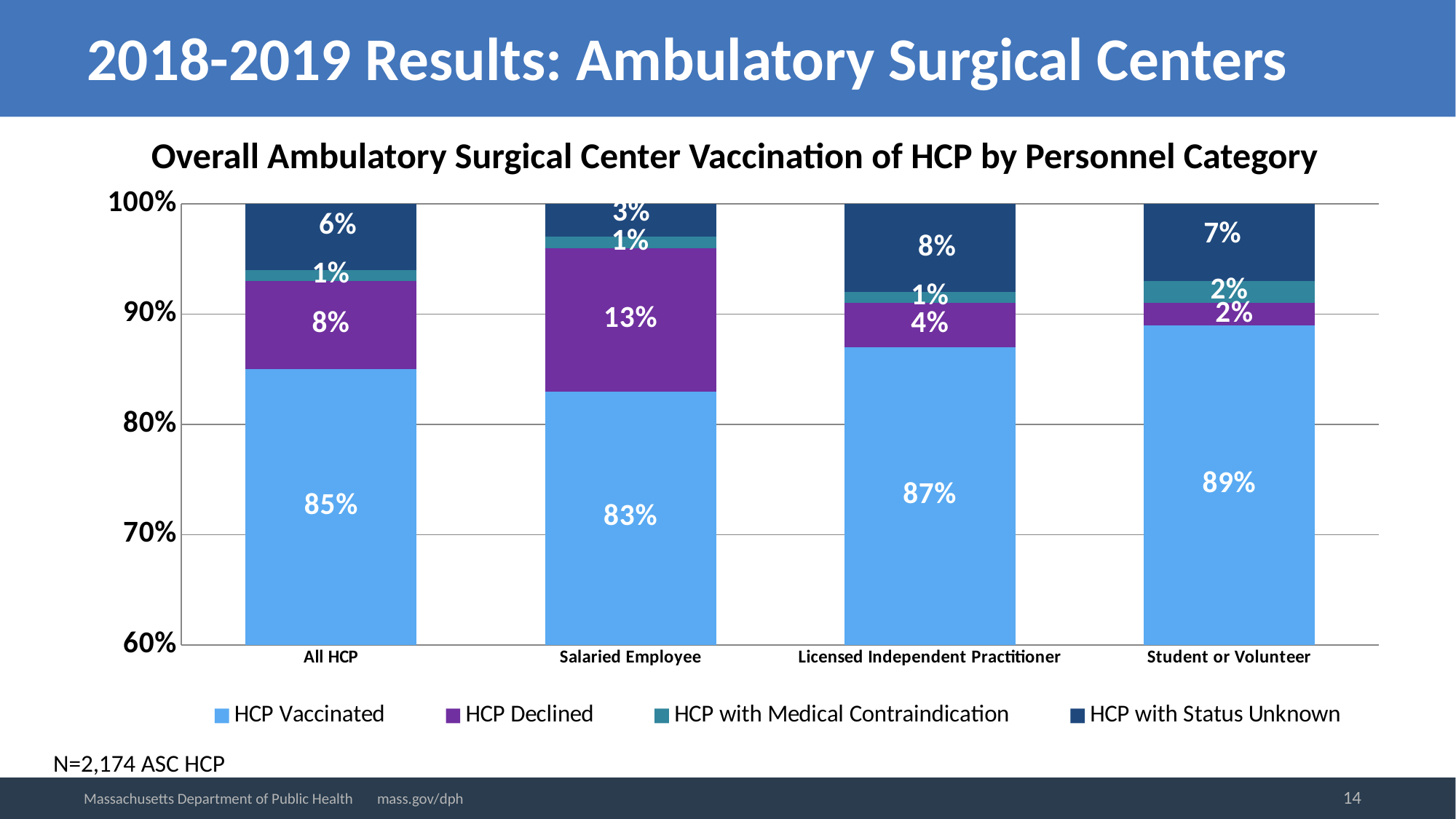
What kind of chart is shown on the slide? Stacked bar chart How many series does the legend list? 4 What is the difference between the HCP Declined percentage for Salaried Employee and for All HCP? 5% What is the title of the chart? Overall Ambulatory Surgical Center Vaccination of HCP by Personnel Category Which is larger: the HCP Vaccinated percentage for Licensed Independent Practitioner or for Salaried Employee? Licensed Independent Practitioner What percentage of Salaried Employee HCP declined vaccination? 13% What is the HCP with Medical Contraindication value for Student or Volunteer? 2% Which personnel category has the lowest HCP Vaccinated percentage? Salaried Employee What percentage of HCP were vaccinated in the All HCP category? 85% Which personnel category has the highest HCP Vaccinated percentage? Student or Volunteer How many personnel categories are shown on the x axis? 4 What is the HCP with Status Unknown value for Licensed Independent Practitioner? 8%